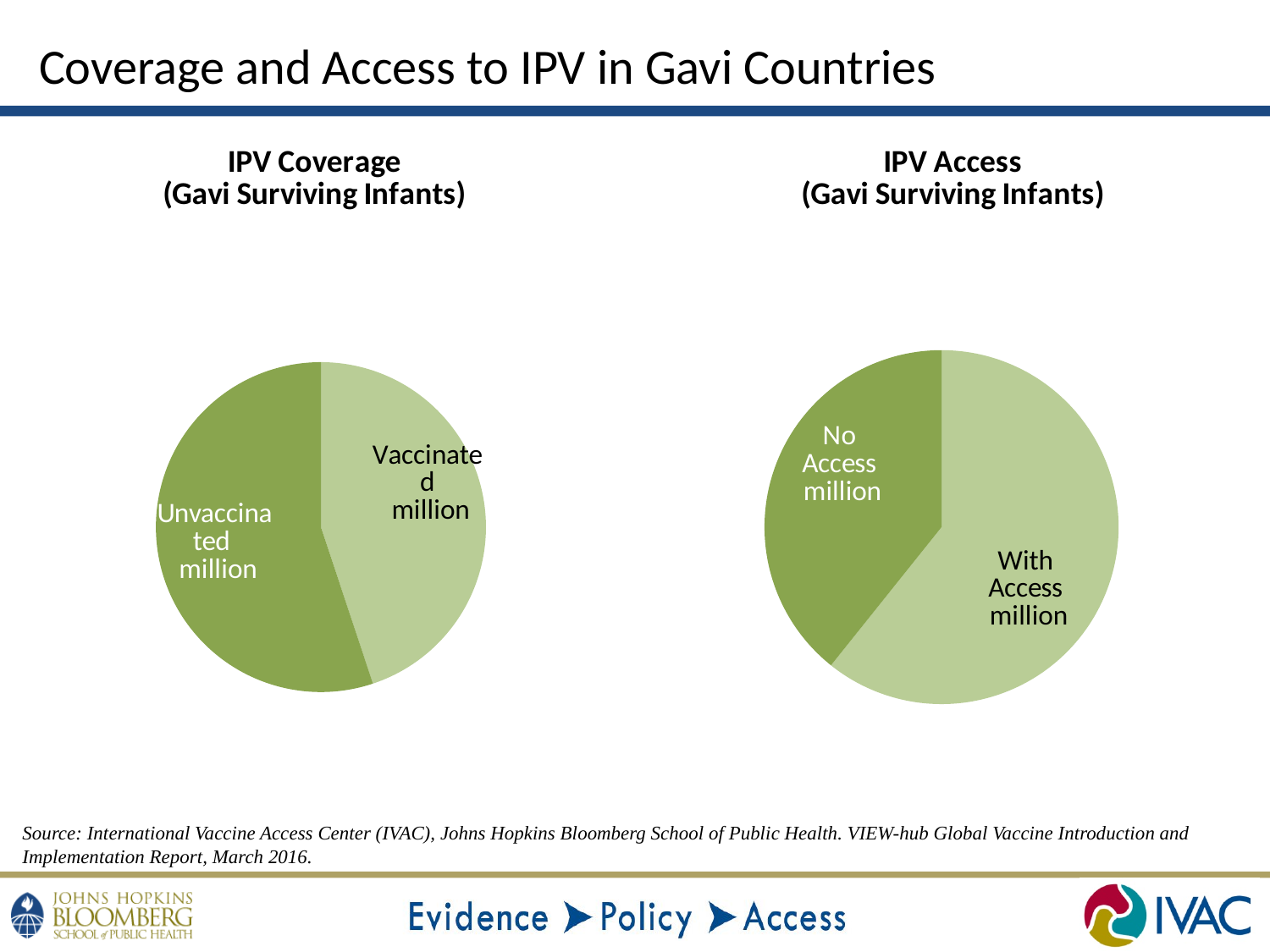
What is the title of the pie chart on the right side of the slide? IPV Access (Gavi Surviving Infants) What kind of chart is the IPV Coverage (Gavi Surviving Infants) chart? pie chart What are the two slice labels in the IPV Coverage (Gavi Surviving Infants) chart? Unvaccinated and Vaccinated How many slices does the IPV Access (Gavi Surviving Infants) pie chart have? 2 In the IPV Coverage (Gavi Surviving Infants) chart, which slice is smaller? Vaccinated In the IPV Coverage (Gavi Surviving Infants) chart, is the Vaccinated slice larger or smaller than the Unvaccinated slice? smaller In the IPV Access (Gavi Surviving Infants) chart, is the With Access slice larger or smaller than the No Access slice? larger In the IPV Access (Gavi Surviving Infants) chart, which slice is larger? With Access How many slices does the IPV Coverage (Gavi Surviving Infants) pie chart have? 2 In the IPV Access (Gavi Surviving Infants) chart, which slice is smaller? No Access In the IPV Coverage (Gavi Surviving Infants) chart, which slice is larger? Unvaccinated What kind of chart is the IPV Access (Gavi Surviving Infants) chart? pie chart